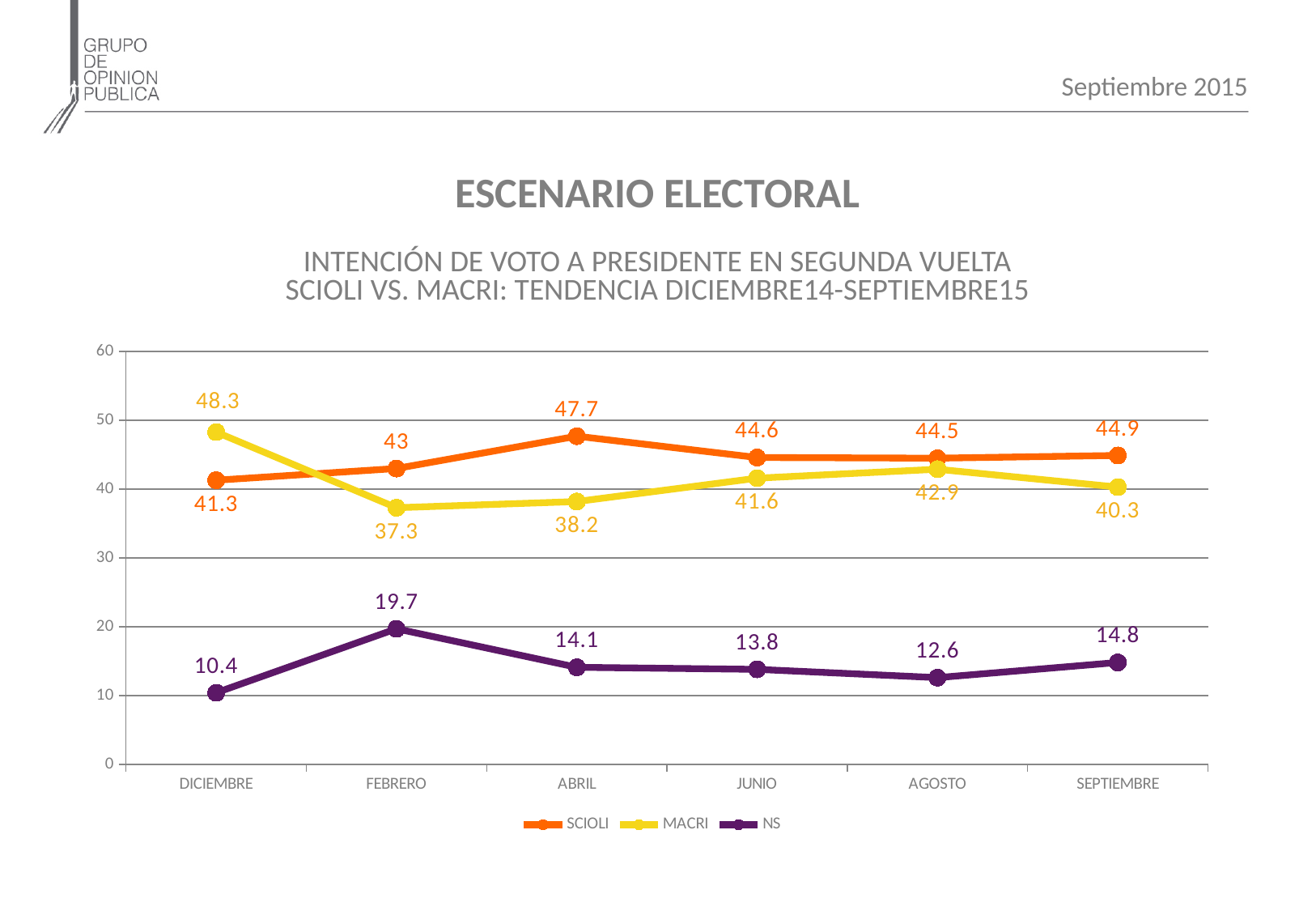
Is the value for NS in AGOSTO greater or less than 20? less What is the difference between SCIOLI and MACRI in SEPTIEMBRE? 4.6 Which is larger in DICIEMBRE, SCIOLI or MACRI? MACRI What is the value for SCIOLI in ABRIL? 47.7 How many months are shown on the x axis? 6 In which month is the MACRI series lowest? FEBRERO In which month is the NS series highest? FEBRERO Does the MACRI series rise or fall from DICIEMBRE to FEBRERO? fall What is the value for MACRI in DICIEMBRE? 48.3 What kind of chart is shown? line chart How many series does the legend list? 3 What is the value for NS in FEBRERO? 19.7